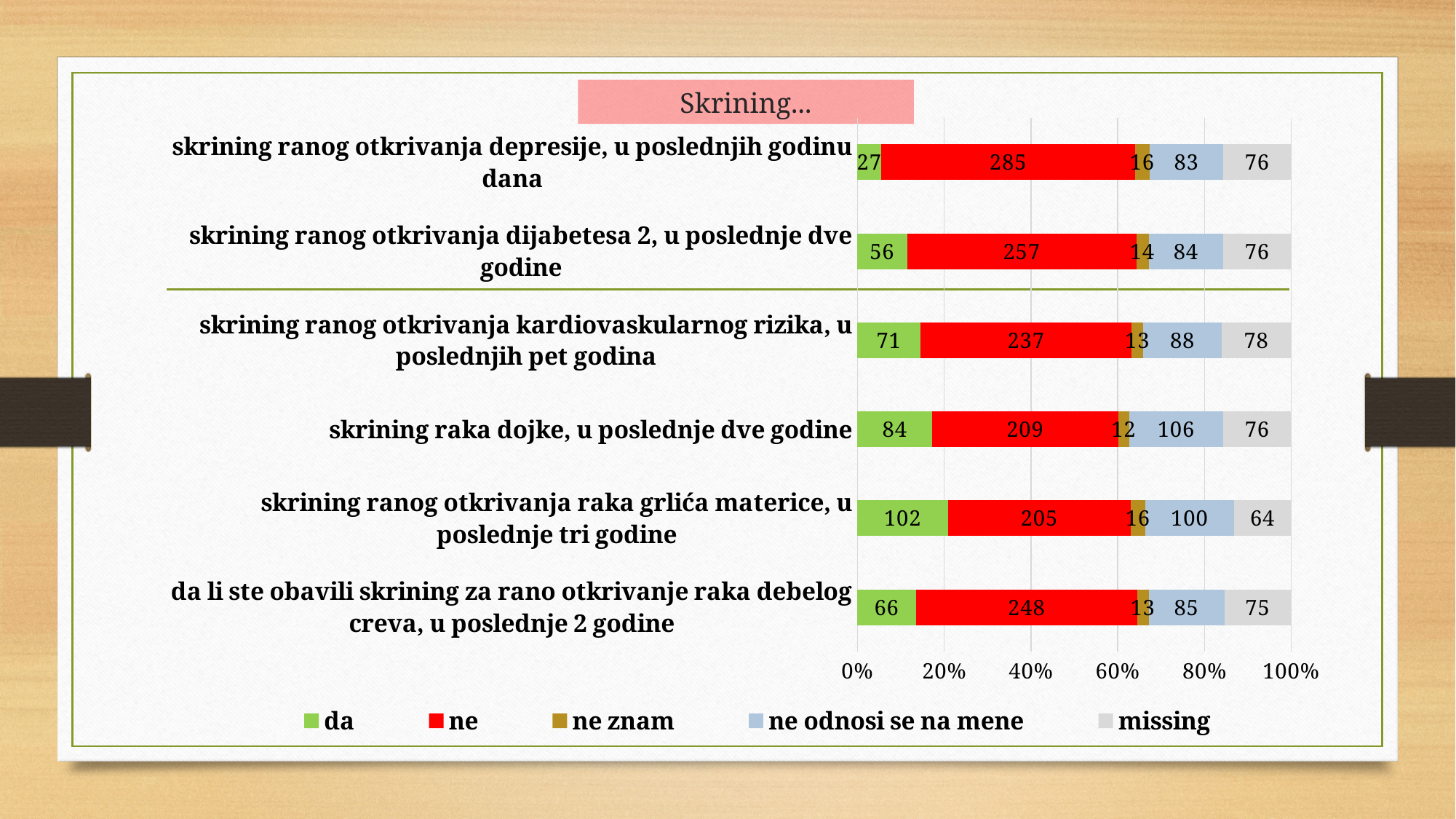
What is the title of the chart? Skrining... What is the 'da' value for 'skrining ranog otkrivanja raka grlića materice, u poslednje tri godine'? 102 What kind of chart is shown on the slide? stacked bar chart How many series does the legend list? 5 What is the 'ne odnosi se na mene' value for 'skrining raka dojke, u poslednje dve godine'? 106 What is the difference between the 'ne' values for 'skrining ranog otkrivanja depresije, u poslednjih godinu dana' and 'skrining ranog otkrivanja raka grlića materice, u poslednje tri godine'? 80 Which is larger: the 'missing' value for 'skrining ranog otkrivanja kardiovaskularnog rizika, u poslednjih pet godina' or for 'skrining ranog otkrivanja raka grlića materice, u poslednje tri godine'? skrining ranog otkrivanja kardiovaskularnog rizika, u poslednjih pet godina Which category has the lowest 'da' value? skrining ranog otkrivanja depresije, u poslednjih godinu dana How many categories (screening questions) are plotted in the chart? 6 What is the 'ne' value for 'skrining ranog otkrivanja depresije, u poslednjih godinu dana'? 285 What is the total of all segments in the bar for 'da li ste obavili skrining za rano otkrivanje raka debelog creva, u poslednje 2 godine'? 487 Which category has the highest 'da' value? skrining ranog otkrivanja raka grlića materice, u poslednje tri godine